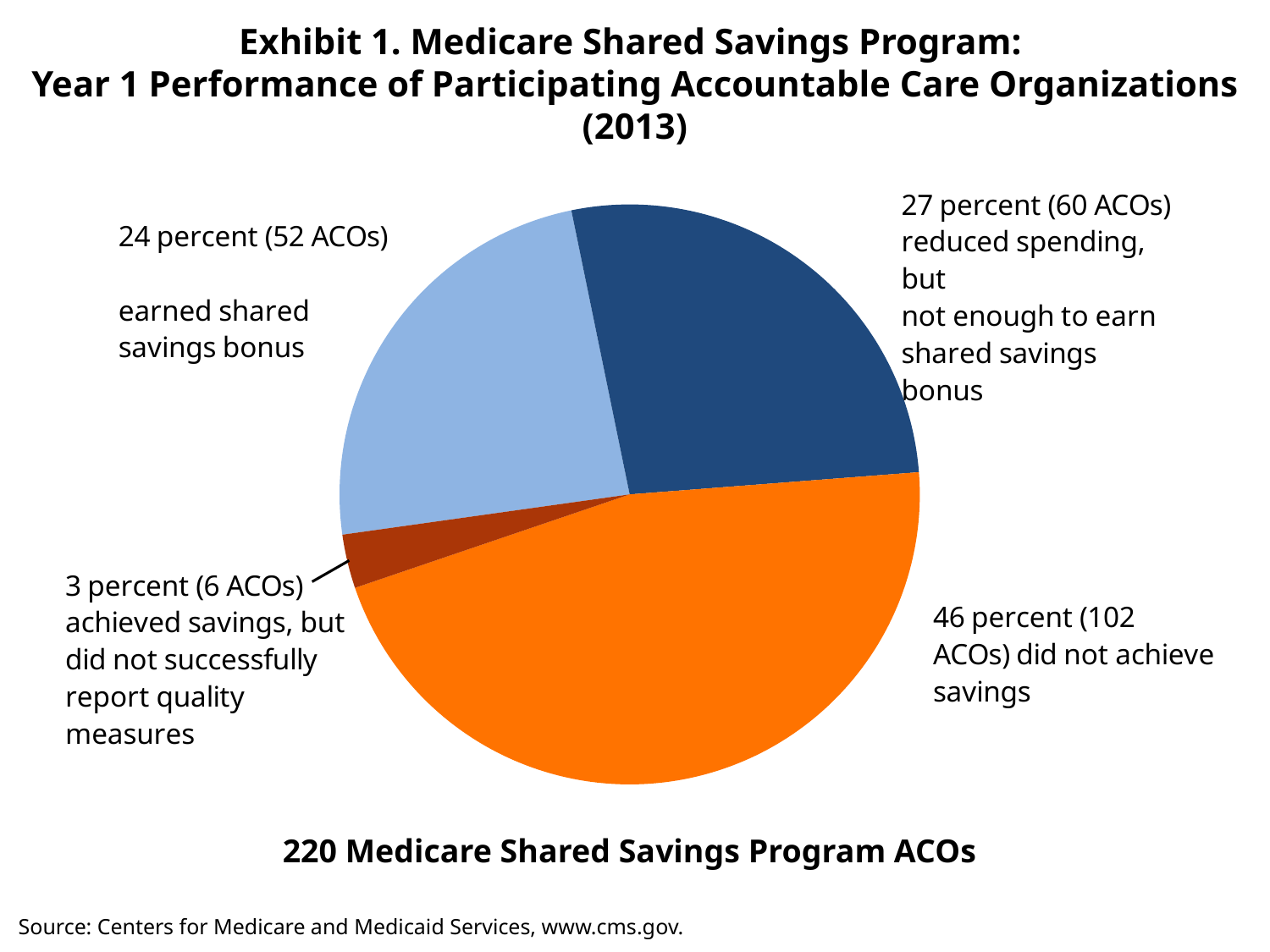
Which is larger: the share of ACOs that earned a shared savings bonus or the share that reduced spending but not enough to earn a bonus? Reduced spending, but not enough to earn shared savings bonus What colour is the slice for ACOs that did not achieve savings? Orange Which category represents the smallest share of the pie? Achieved savings, but did not successfully report quality measures What is the total number of Medicare Shared Savings Program ACOs shown below the chart? 220 How many slices does the pie chart have? 4 How many ACOs earned a shared savings bonus? 52 ACOs Which category represents the largest share of the pie? Did not achieve savings How many ACOs achieved savings but did not successfully report quality measures? 6 ACOs How many more ACOs did not achieve savings than earned a shared savings bonus? 50 ACOs What kind of chart is shown on the slide? Pie chart What percentage of ACOs did not achieve savings? 46 percent What percentage of ACOs reduced spending but not enough to earn a shared savings bonus? 27 percent